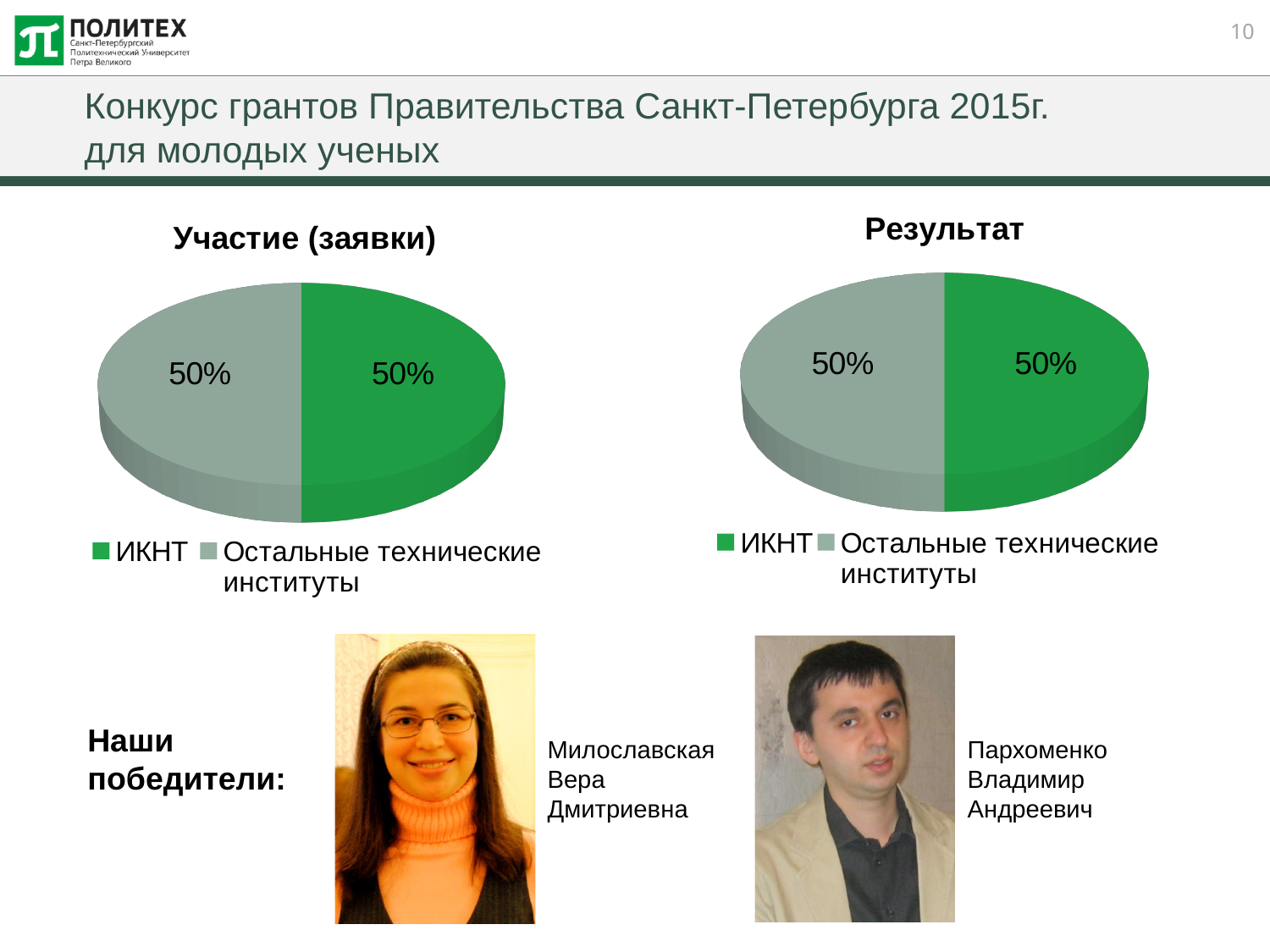
How many slices does the chart titled "Участие (заявки)" have? 2 In the chart titled "Участие (заявки)", what is the difference between the ИКНТ value and the Остальные технические институты value? 0% In the chart titled "Участие (заявки)", what share of the pie does ИКНТ have? 50% How many entries does the legend of the chart titled "Результат" list? 2 What is the title of the left pie chart on the slide? Участие (заявки) In the chart titled "Результат", what share of the pie does ИКНТ have? 50% In the chart titled "Результат", what is the value shown for Остальные технические институты? 50% In the chart titled "Результат", which colour represents ИКНТ? Green What kind of chart is the chart titled "Участие (заявки)"? Pie chart In the chart titled "Участие (заявки)", what is the value shown for Остальные технические институты? 50% How many slices does the chart titled "Результат" have? 2 What kind of chart is the chart titled "Результат"? Pie chart